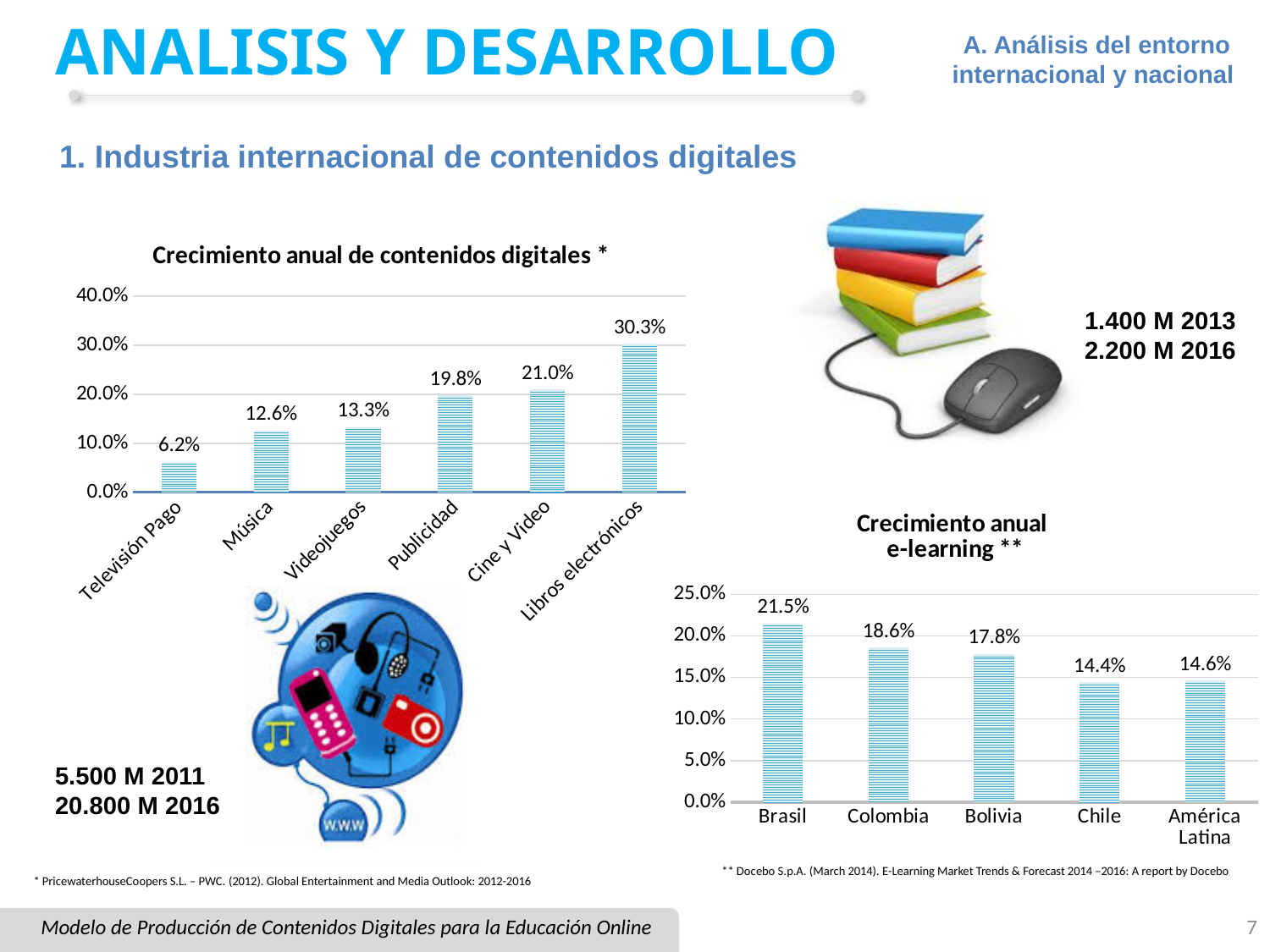
In the 'Crecimiento anual e-learning **' chart, what is the difference between Brasil and Bolivia? 3.7% In the 'Crecimiento anual e-learning **' chart, which category has the lowest value? Chile In the 'Crecimiento anual e-learning **' chart, what is the value for Colombia? 18.6% In the 'Crecimiento anual de contenidos digitales *' chart, which category has the lowest value? Televisión Pago What kind of chart is the 'Crecimiento anual e-learning **' chart? bar chart In the 'Crecimiento anual de contenidos digitales *' chart, what is the value for Libros electrónicos? 30.3% In the 'Crecimiento anual e-learning **' chart, which country has the highest value? Brasil In the 'Crecimiento anual de contenidos digitales *' chart, which category has the highest value? Libros electrónicos In the 'Crecimiento anual de contenidos digitales *' chart, what is the value for Televisión Pago? 6.2% In the 'Crecimiento anual de contenidos digitales *' chart, how many categories are shown? 6 In the 'Crecimiento anual de contenidos digitales *' chart, do the values rise or fall from left to right? rise In the 'Crecimiento anual de contenidos digitales *' chart, what is the difference between Cine y Video and Publicidad? 1.2%